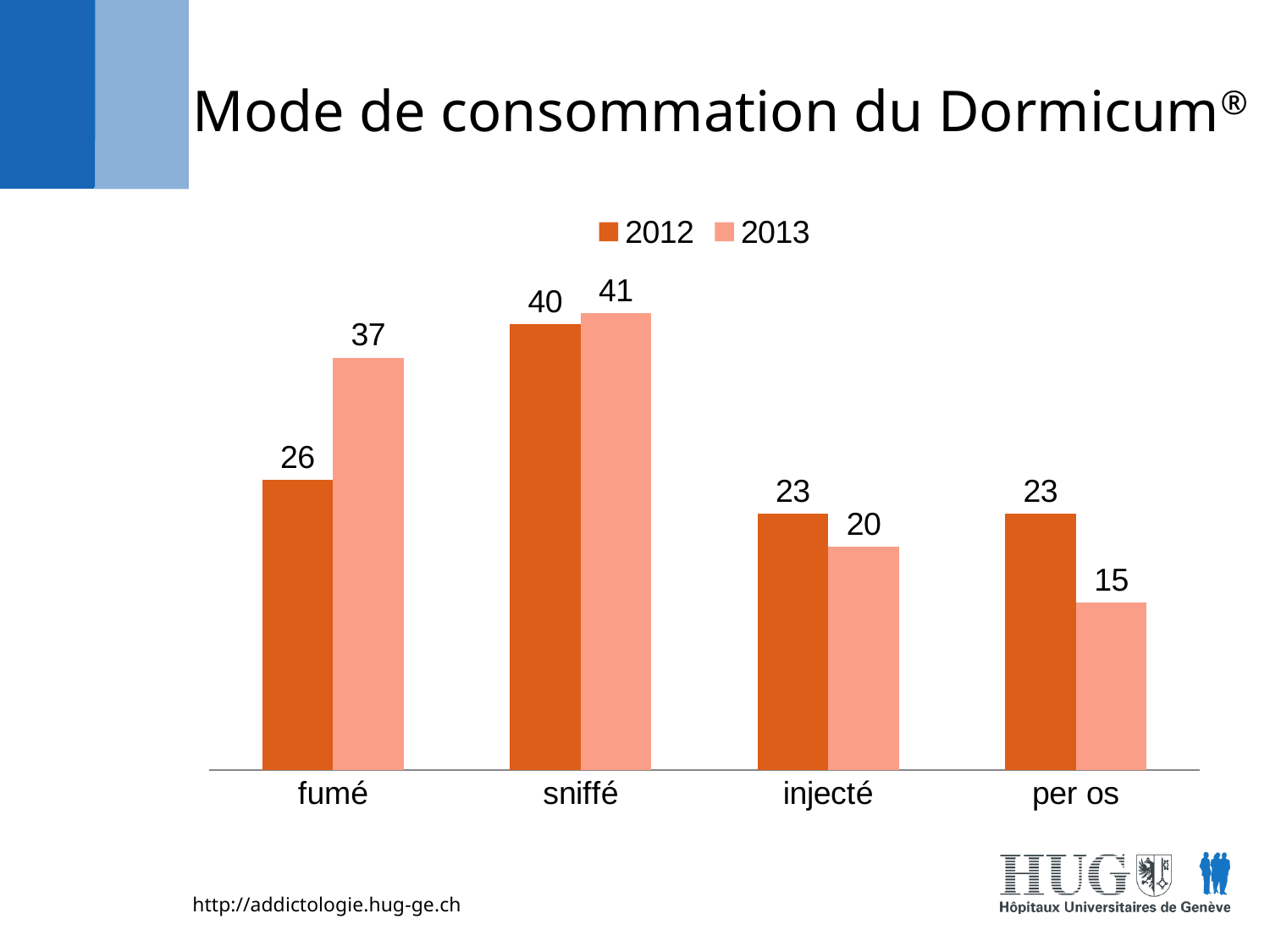
Which category has the lowest value in 2013? per os What kind of chart is shown on the slide? bar chart What is the value for 'fumé' in 2012? 26 How many categories are shown on the x axis? 4 What is the value for 'sniffé' in 2013? 41 What is the difference between the 2013 and 2012 values for 'fumé'? 11 Which category has the highest value in 2013? sniffé What is the value for 'injecté' in 2012? 23 What is the difference between the 2012 and 2013 values for 'per os'? 8 Which is larger for 'injecté': the 2012 value or the 2013 value? 2012 How many series does the legend list? 2 What is the value for 'per os' in 2013? 15